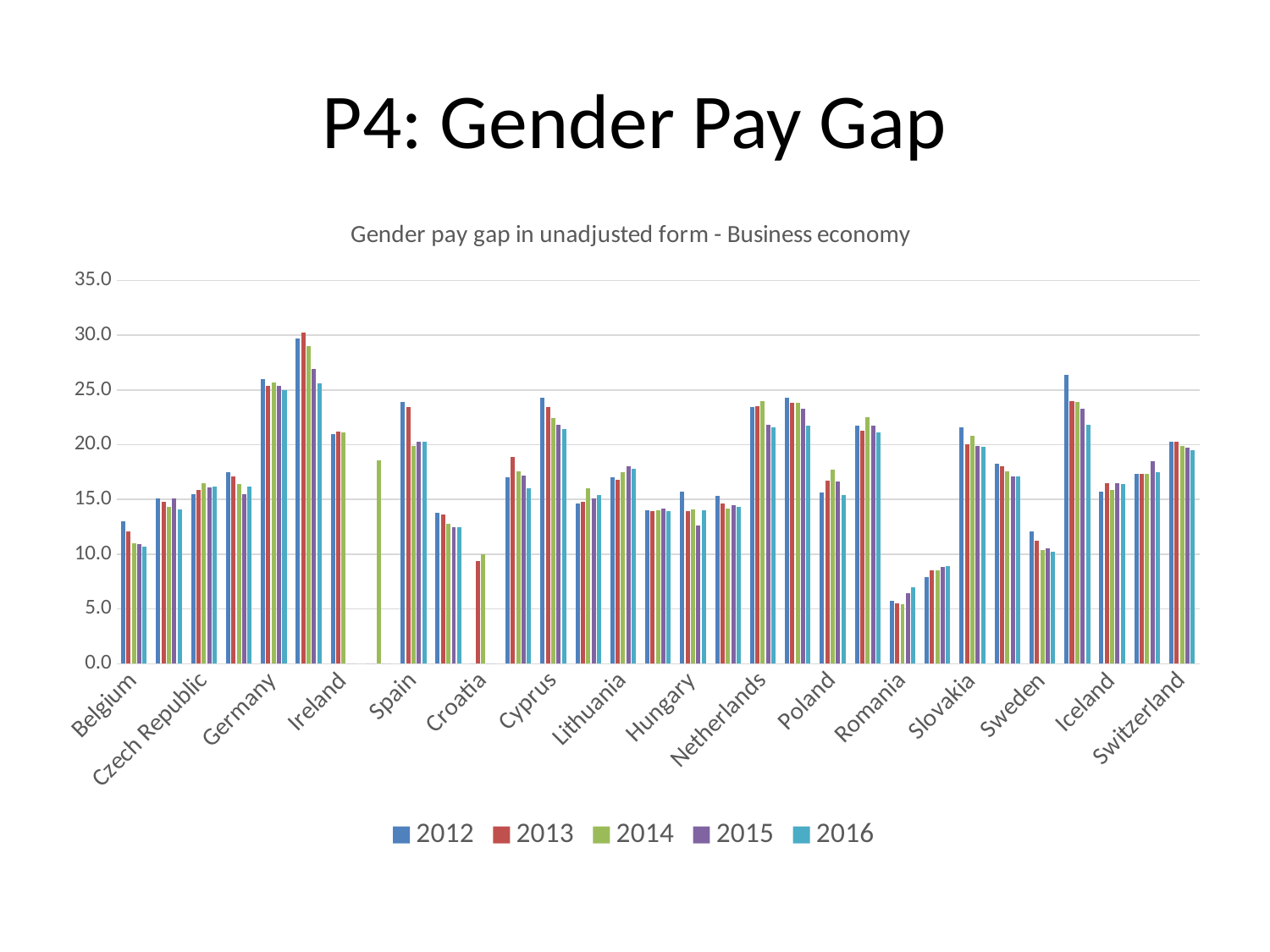
What kind of chart is shown on the slide? bar chart How many series does the legend list? 5 Is the 2012 value for Sweden greater or less than 15.0? less Which has the larger 2012 value, Germany or Belgium? Germany Is the 2012 value for Germany greater or less than 25.0? greater What is the title of the chart? Gender pay gap in unadjusted form - Business economy Which years are listed in the legend? 2012, 2013, 2014, 2015, 2016 Is the 2014 value for the Netherlands greater or less than 20.0? greater Do the values for Romania rise or fall from 2012 to 2016? rise Which of the labeled countries has the lowest 2012 value? Romania